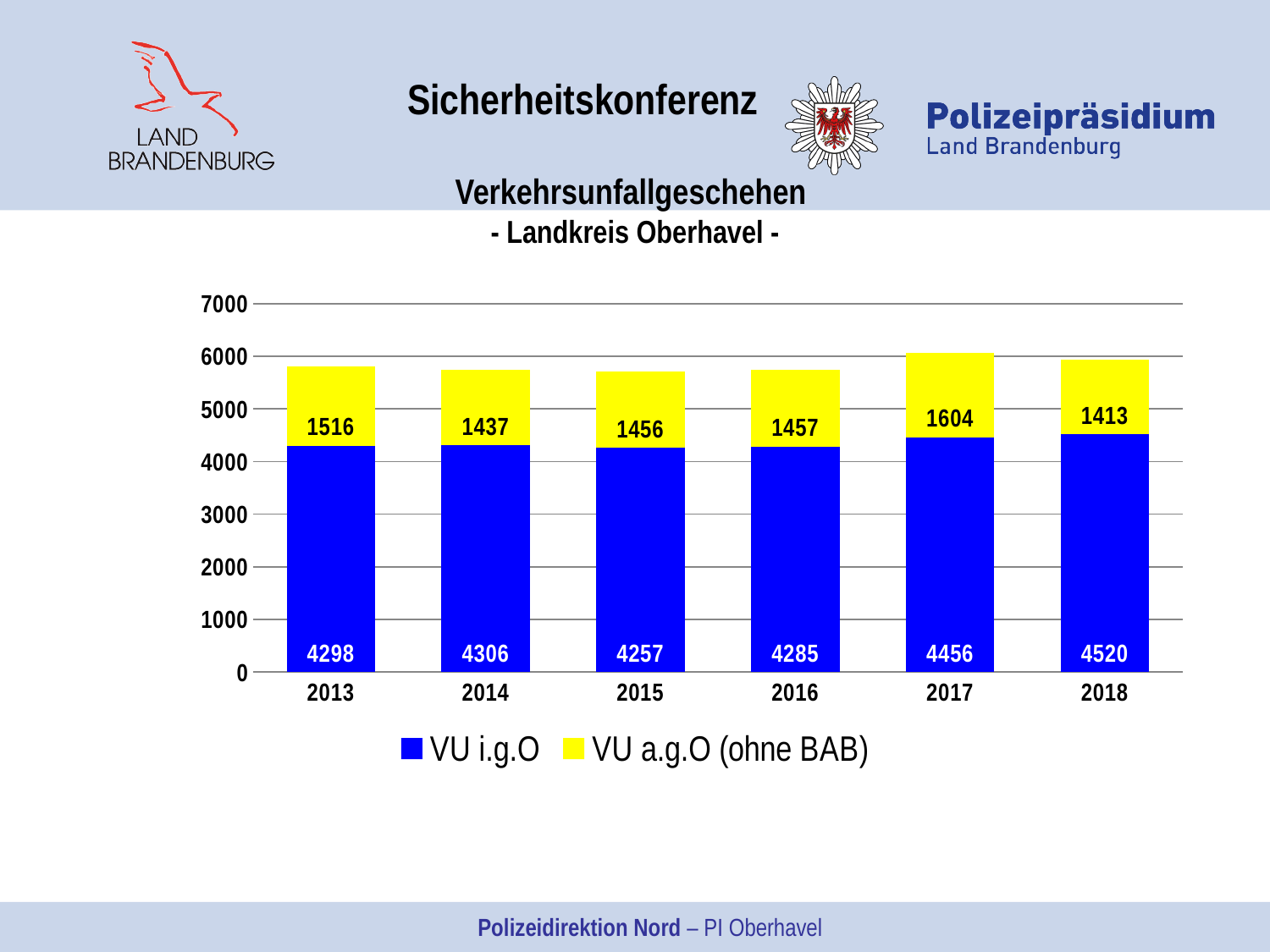
What is the difference between the VU i.g.O values for 2018 and 2013? 222 How many years are shown on the x axis? 6 How many series does the legend list? 2 Which year has the lowest value for VU i.g.O? 2015 Which year has the highest value for VU a.g.O (ohne BAB)? 2017 What is the value for VU i.g.O in 2015? 4257 What is the total of the stacked bar for 2017? 6060 What kind of chart is shown on the slide? Stacked bar chart Which colour represents VU a.g.O (ohne BAB) in the chart? Yellow What is the value for VU i.g.O in 2018? 4520 Which is larger, the VU a.g.O (ohne BAB) value for 2013 or for 2014? 2013 What is the value for VU a.g.O (ohne BAB) in 2017? 1604